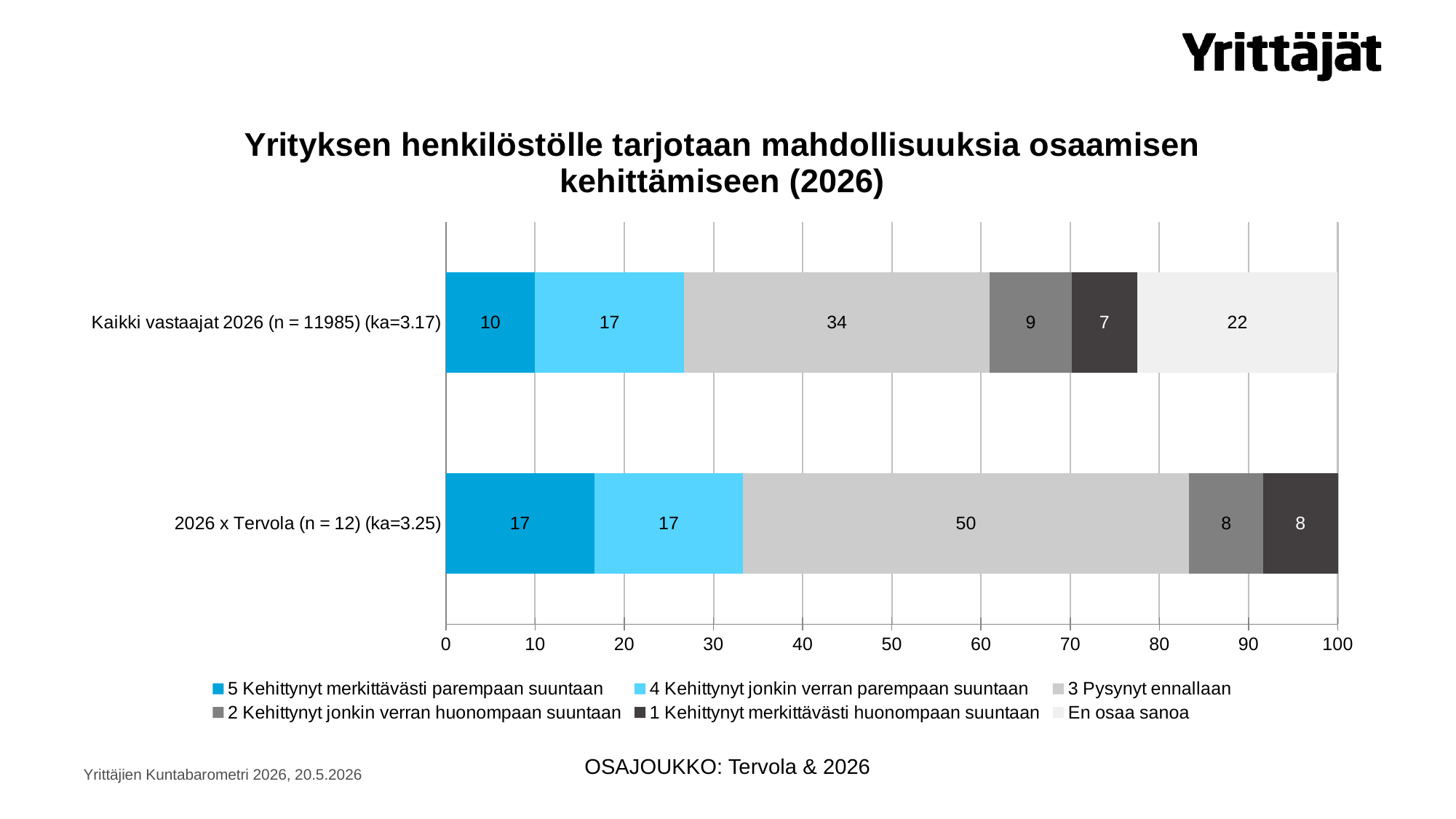
What is the value of 'En osaa sanoa' for 'Kaikki vastaajat 2026 (n = 11985) (ka=3.17)'? 22 What is the total of the stacked bar for '2026 x Tervola (n = 12) (ka=3.25)'? 100 What is the difference between the '3 Pysynyt ennallaan' values for '2026 x Tervola (n = 12) (ka=3.25)' and 'Kaikki vastaajat 2026 (n = 11985) (ka=3.17)'? 16 Which segment is the largest in the bar for 'Kaikki vastaajat 2026 (n = 11985) (ka=3.17)'? 3 Pysynyt ennallaan How many categories (bars) are shown in the chart? 2 Which category has the larger value for '5 Kehittynyt merkittävästi parempaan suuntaan'? 2026 x Tervola (n = 12) (ka=3.25) What is the value of '3 Pysynyt ennallaan' for '2026 x Tervola (n = 12) (ka=3.25)'? 50 What is the value of '5 Kehittynyt merkittävästi parempaan suuntaan' for 'Kaikki vastaajat 2026 (n = 11985) (ka=3.17)'? 10 What is the title of the chart? Yrityksen henkilöstölle tarjotaan mahdollisuuksia osaamisen kehittämiseen (2026) What type of chart is shown on the slide? Stacked bar chart What is the value of '1 Kehittynyt merkittävästi huonompaan suuntaan' for '2026 x Tervola (n = 12) (ka=3.25)'? 8 How many series does the legend list? 6